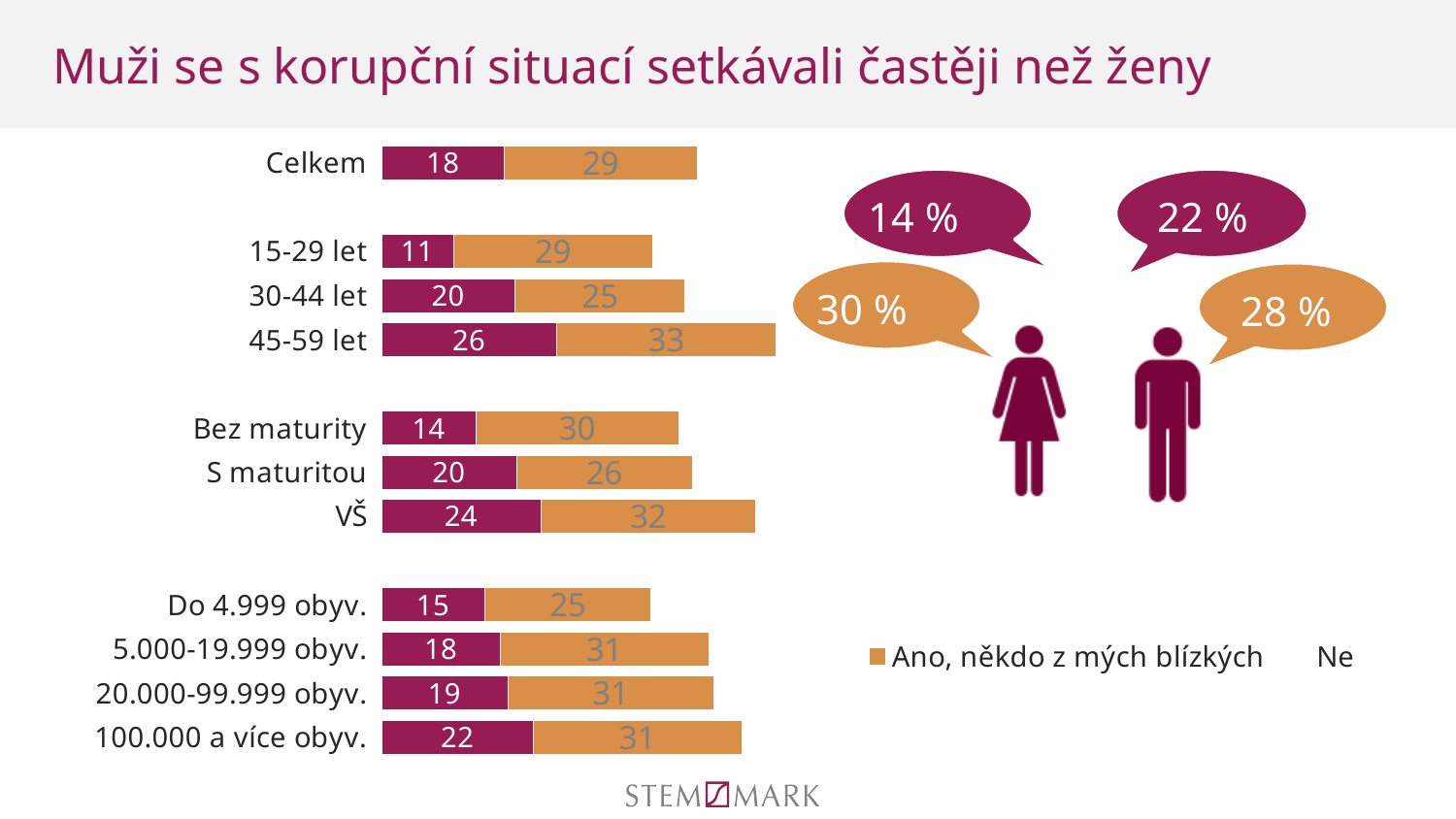
Which category has the lowest value in the magenta (first) segment? 15-29 let What is the difference between the magenta segment values for '45-59 let' and '15-29 let'? 15 What is the total of the two segments for the 'Celkem' bar? 47 What type of chart is shown on the slide? Stacked bar chart What is the value of the orange segment for 'Bez maturity'? 30 Which category has the highest value in the magenta (first) segment? 45-59 let What is the value of the magenta (first) segment for the '45-59 let' category? 26 What is the value of the magenta (first) segment for '15-29 let'? 11 What is the total of the two segments for the '45-59 let' bar? 59 What is the value of the orange segment for the 'VŠ' category? 32 How many categories are shown in the bar chart? 11 Which has the larger orange segment value: 'Do 4.999 obyv.' or '5.000-19.999 obyv.'? 5.000-19.999 obyv.